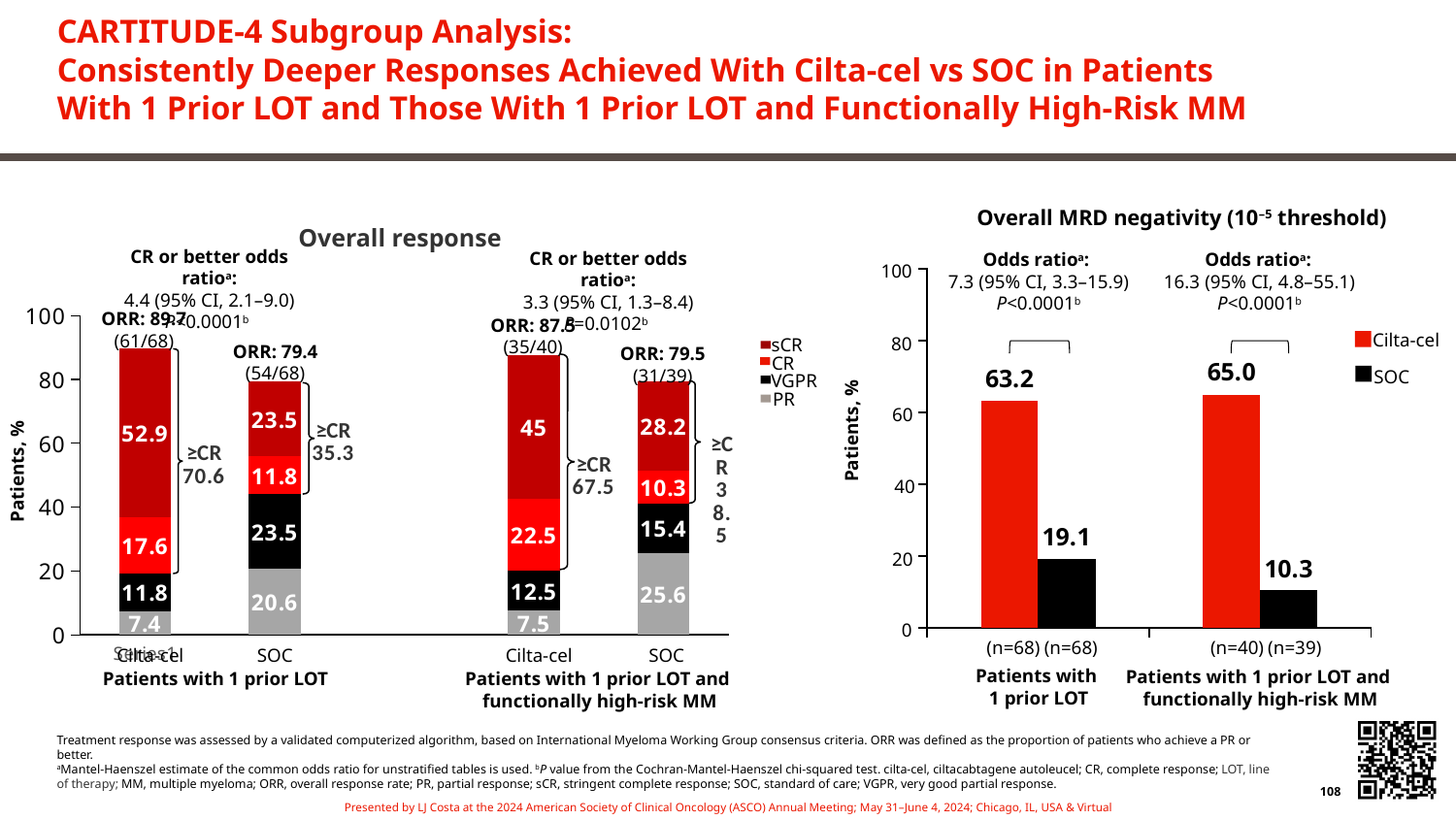
In the Overall MRD negativity chart, what is the value for SOC in patients with 1 prior LOT? 19.1 In the Overall MRD negativity chart, what is the value for Cilta-cel in patients with 1 prior LOT and functionally high-risk MM? 65.0 In the Overall response chart, what is the sCR value for Cilta-cel in patients with 1 prior LOT? 52.9 In the Overall MRD negativity chart, which bar is the lowest? SOC in patients with 1 prior LOT and functionally high-risk MM In the Overall response chart, which has the larger CR value in patients with 1 prior LOT, Cilta-cel or SOC? Cilta-cel In the Overall response chart, what is the PR value for SOC in patients with 1 prior LOT and functionally high-risk MM? 25.6 In the Overall response chart, what is the difference between the sCR values for Cilta-cel and SOC in patients with 1 prior LOT and functionally high-risk MM? 16.8 What kind of chart is the Overall MRD negativity chart? Bar chart In the Overall MRD negativity chart, what is the difference between Cilta-cel and SOC in patients with 1 prior LOT? 44.1 In the Overall MRD negativity chart, what is the y-axis label? Patients, % In the Overall response chart, how many series does the legend list? 4 In the Overall response chart, what is the ORR for SOC in patients with 1 prior LOT? 79.4